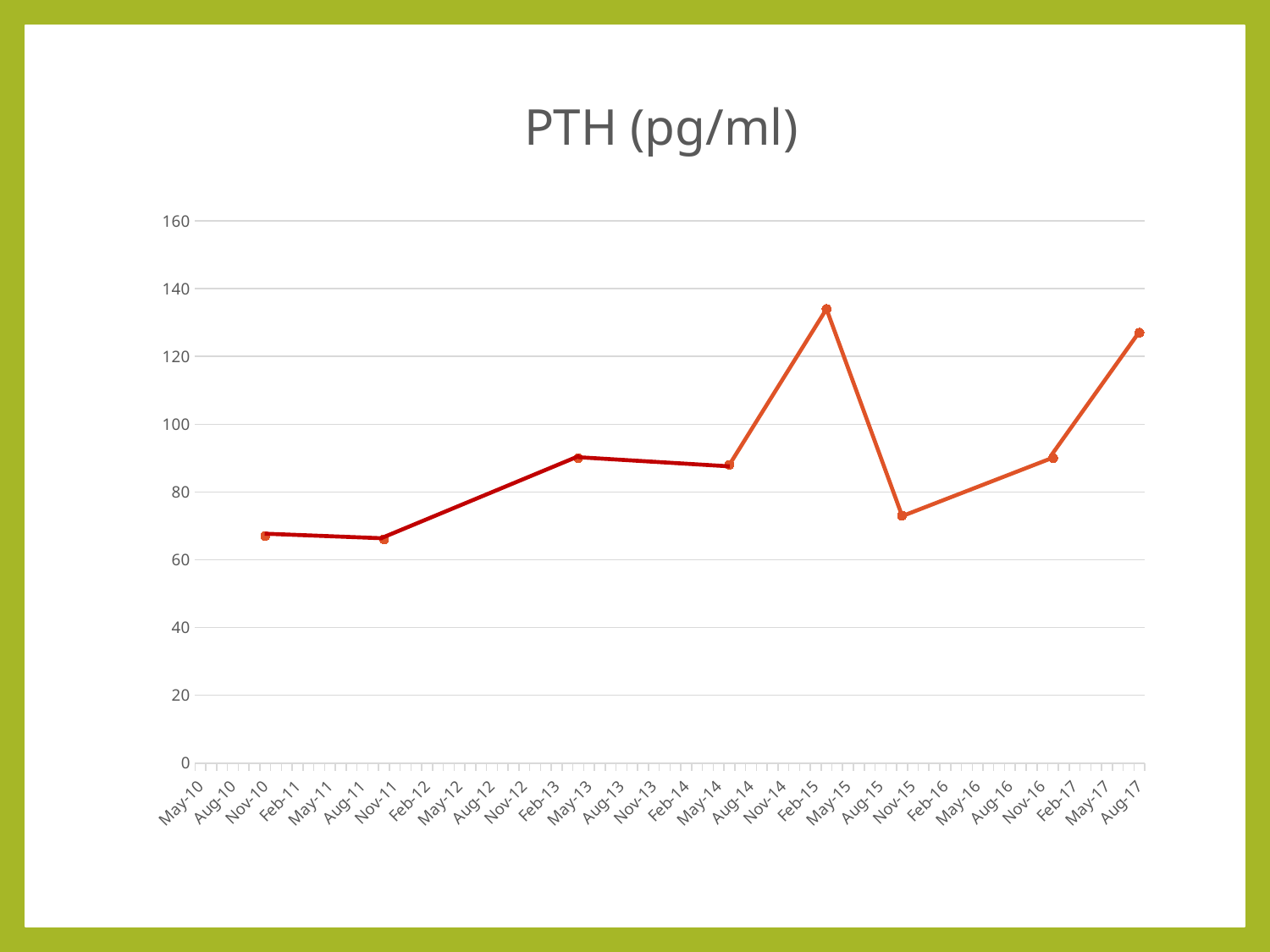
Is the value for Feb-15 greater or less than 120? greater Which has the larger PTH value, Feb-15 or Nov-15? Feb-15 Which has the larger PTH value, Aug-17 or Nov-16? Aug-17 Is the value for Nov-10 greater or less than 60? greater Is the value for Aug-17 greater or less than 120? greater What kind of chart is shown on the slide? line chart What is the title of the chart? PTH (pg/ml) How many data points are plotted on the line? 8 Do the PTH values rise or fall from Nov-15 to Aug-17? rise